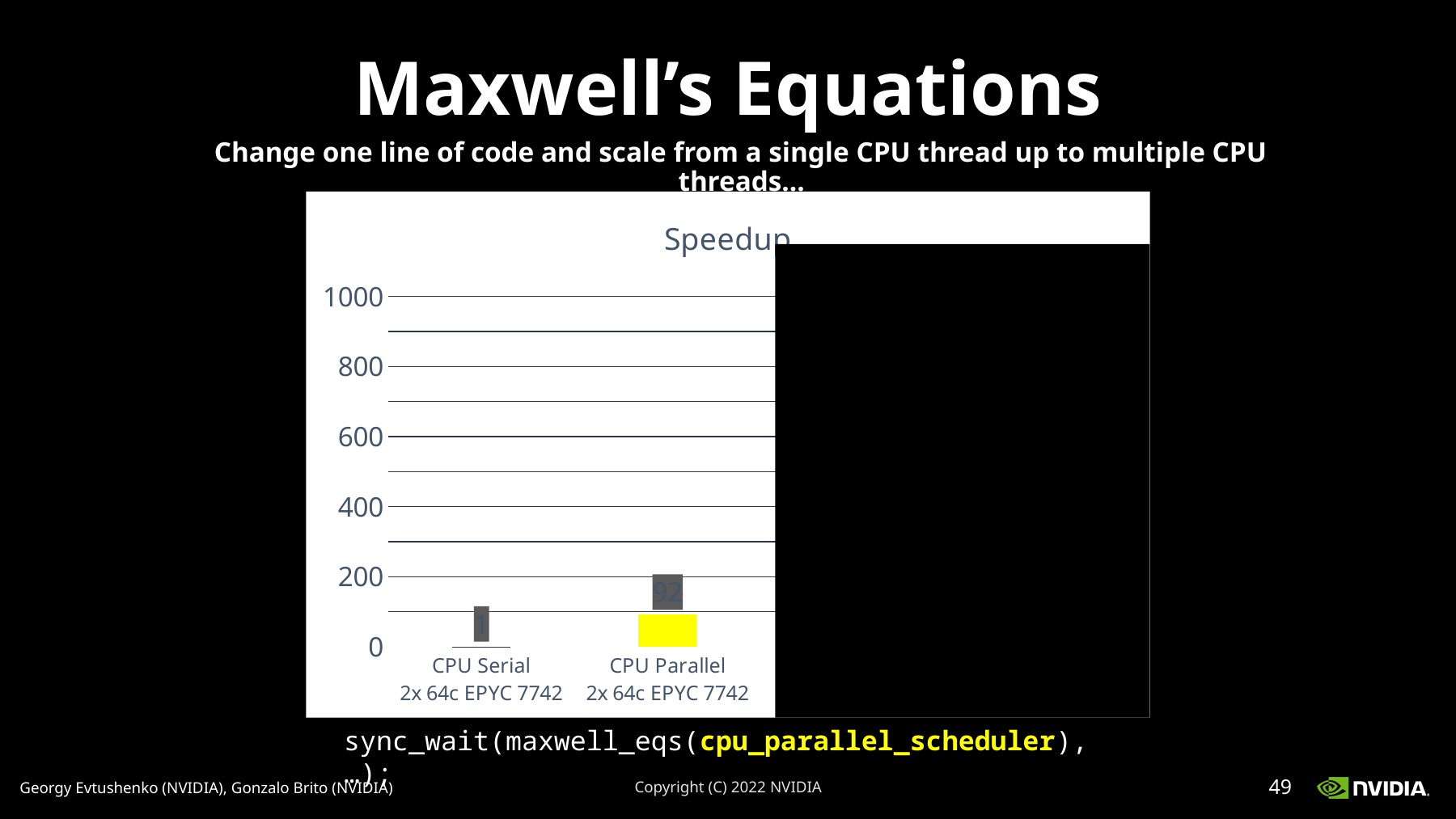
Which category has the higher speedup, CPU Serial or CPU Parallel? CPU Parallel Do the values rise or fall from CPU Serial to CPU Parallel? rise How many categories are visible on the x axis of the chart? 2 What is the difference in speedup between CPU Parallel and CPU Serial? 91 What is the highest value shown on the y axis of the chart? 1000 Is the speedup value for CPU Parallel greater or less than 200? less Which visible category has the lowest speedup? CPU Serial What type of chart is shown on the slide? bar chart What is the title of the chart? Speedup What is the speedup value for CPU Serial? 1 What is the speedup value for CPU Parallel? 92